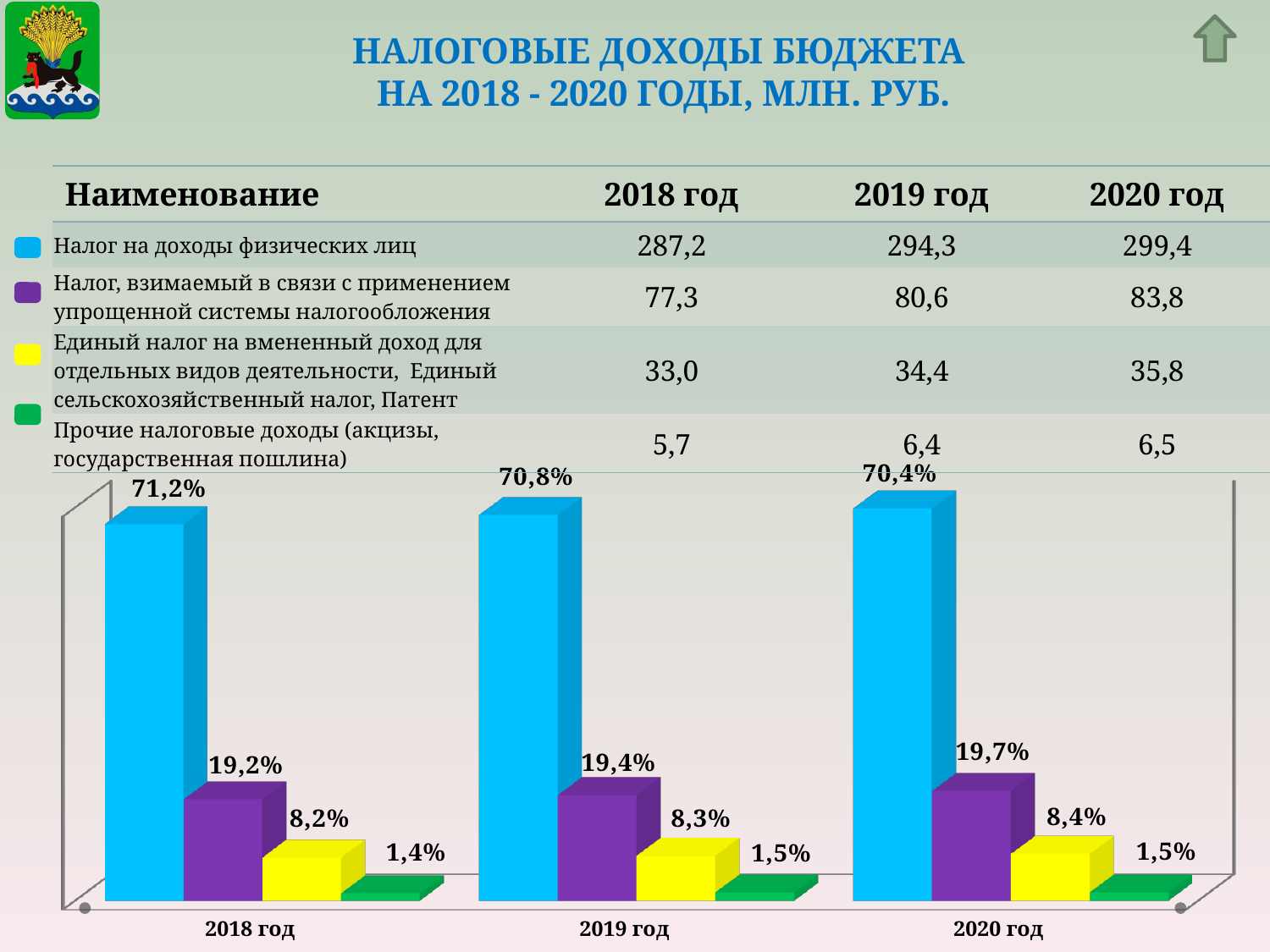
In the chart, what is the difference between the blue bar values for 2018 год and 2020 год? 0,8% In the chart, what is the data label on the green bar for 2018 год? 1,4% How many coloured series (bars per year) does the chart show? 4 In the chart, which bar has the lowest value in 2020 год? the green bar (Прочие налоговые доходы), 1,5% How many year categories are shown on the x axis of the chart? 3 What kind of chart is shown at the bottom of the slide? bar chart In the chart, what is the data label on the purple bar for 2020 год? 19,7% In the chart, is the purple bar value larger in 2019 год or in 2020 год? 2020 год In the chart, what is the data label on the blue bar for 2018 год? 71,2% In the chart, what is the data label on the yellow bar for 2019 год? 8,3%